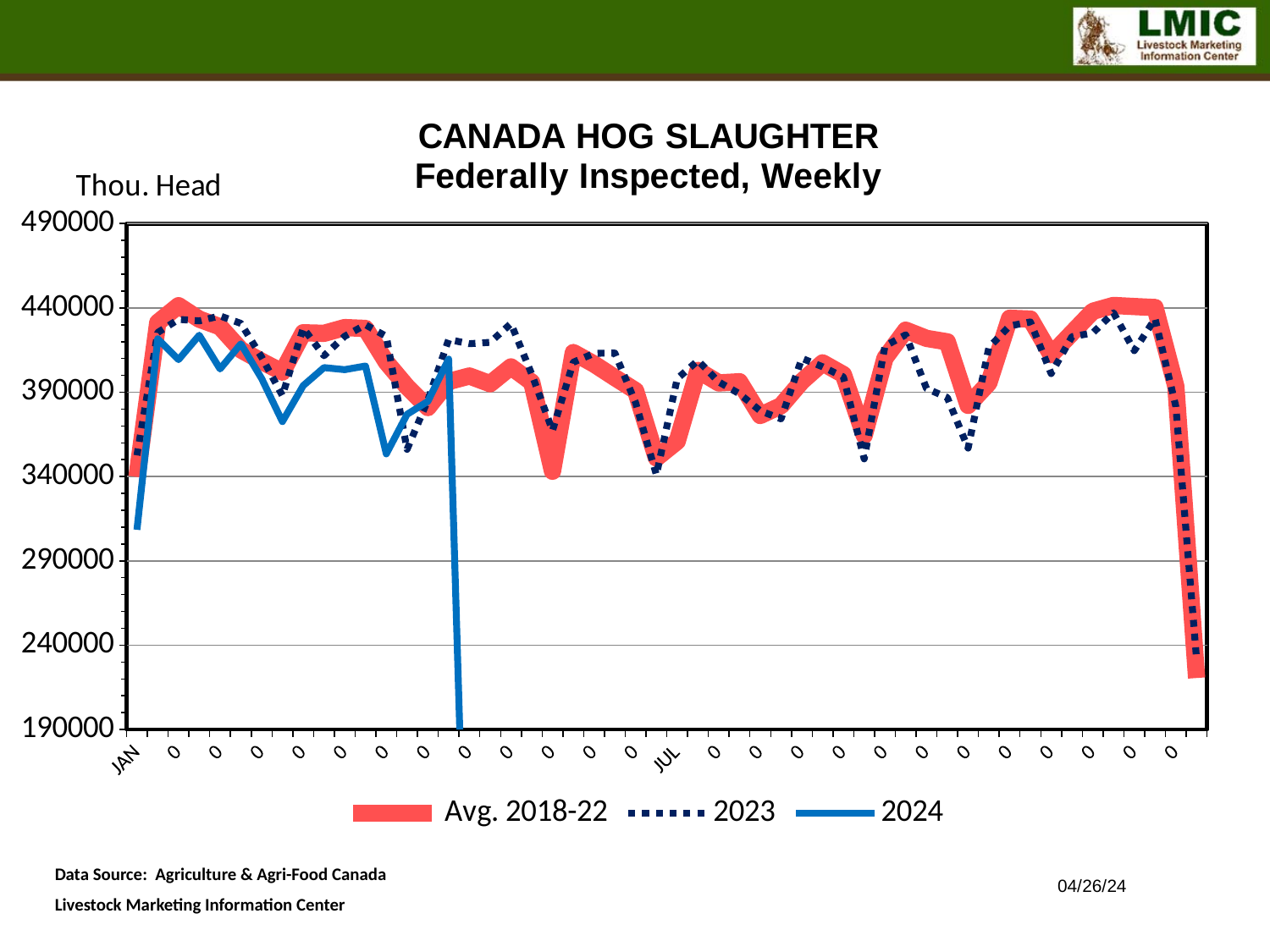
What kind of chart is shown on the slide? line chart What is the title of the chart? CANADA HOG SLAUGHTER Federally Inspected, Weekly Is the final value of the Avg. 2018-22 series at the end of the year greater or less than 240000? less How many series does the legend list? 3 Does the 2024 series rise or fall between JAN and the second week plotted? rise What unit is shown on the vertical axis label? Thou. Head At JAN, which series has the higher value, Avg. 2018-22 or 2024? Avg. 2018-22 Is the highest value of the 2024 series greater or less than 390000? greater Is the value of the 2024 series at JAN greater or less than 340000? less Does the Avg. 2018-22 series rise or fall over the last few weeks of the year? fall